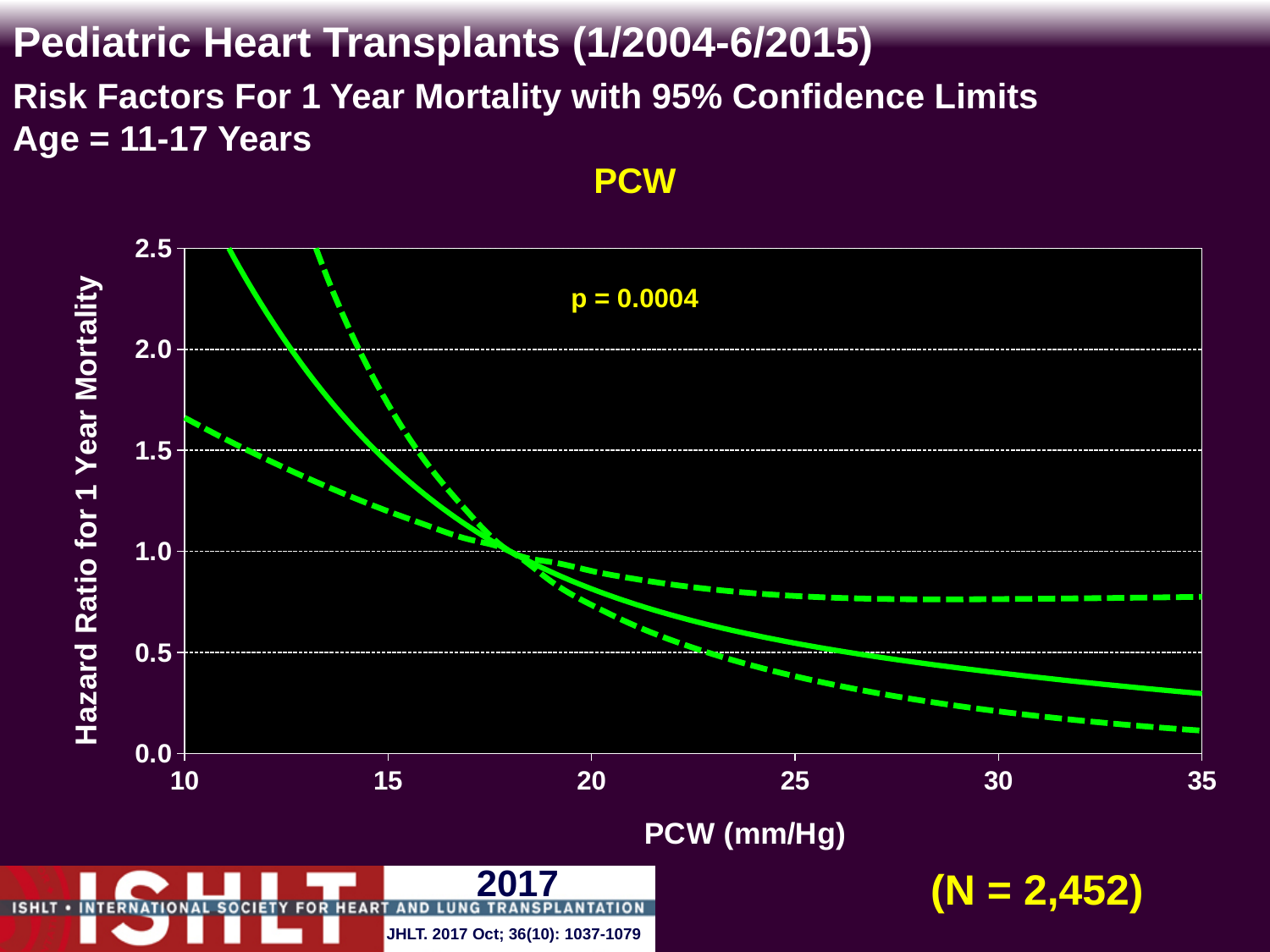
Which has the higher hazard ratio on the solid line: a PCW of 15 mm/Hg or a PCW of 30 mm/Hg? 15 mm/Hg Is the hazard ratio (solid line) at a PCW of 20 mm/Hg greater or less than 1.0? less What kind of chart is shown on the slide? line chart Is the hazard ratio (solid line) at a PCW of 30 mm/Hg greater or less than 0.5? less What sample size (N) is shown on the slide? N = 2,452 What p-value is printed on the chart? p = 0.0004 Is the upper confidence limit (upper dashed line) at a PCW of 35 mm/Hg greater or less than 0.5? greater Does the hazard ratio for 1 year mortality rise or fall as PCW increases from 10 to 35 mm/Hg? fall How many curves are plotted on the chart? 3